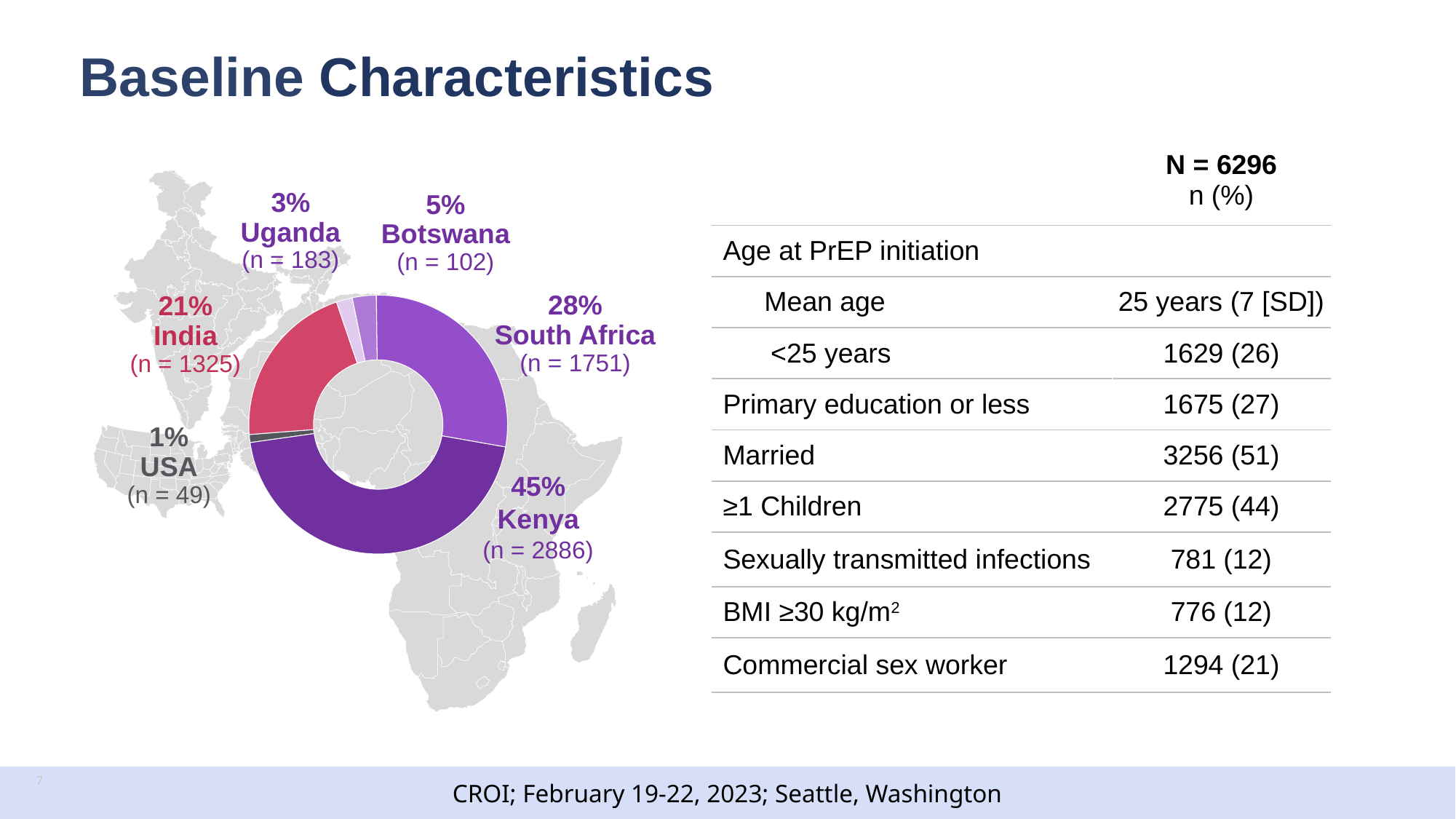
What colour is the India slice in the pie chart? Red How many countries are shown in the pie chart? 6 How many participants (n) are from South Africa according to the pie chart? 1751 What percentage of participants are from Uganda according to the pie chart? 3% What is the difference in participant numbers between Kenya and South Africa in the pie chart? 1135 What is the combined number of participants from Uganda and Botswana in the pie chart? 285 Which country has the largest slice in the pie chart? Kenya How many participants are from the USA according to the pie chart? 49 Which country has the smallest slice in the pie chart? USA What share of participants does Kenya account for in the pie chart? 45% Which has more participants in the pie chart, India or Botswana? India What kind of chart is shown on the slide? Pie chart (donut)